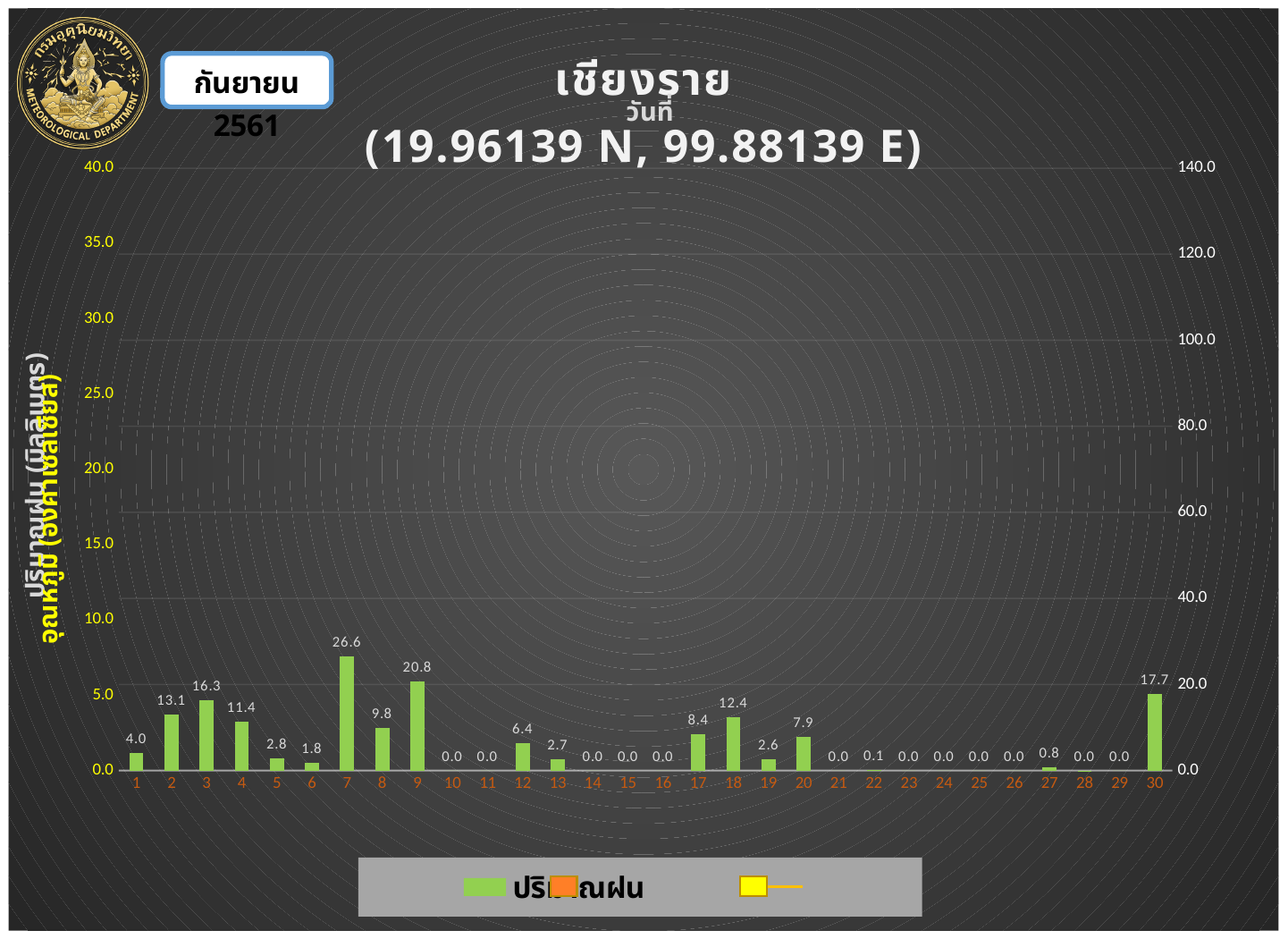
What colour are the rainfall (ปริมาณฝน) bars in the chart? green What is the rainfall value shown for day 22? 0.1 What is the rainfall value shown for day 7? 26.6 Which has a larger rainfall value, day 4 or day 18? day 18 Which day has the highest rainfall value? 7 What is the rainfall value shown for day 18? 12.4 What is the difference between the rainfall values for day 3 and day 2? 3.2 Which has a larger rainfall value, day 9 or day 30? day 9 What kind of chart is shown on the slide? bar chart How many days are shown on the x axis of the chart? 30 What is the difference between the rainfall values for day 7 and day 9? 5.8 What is the rainfall value shown for day 30? 17.7